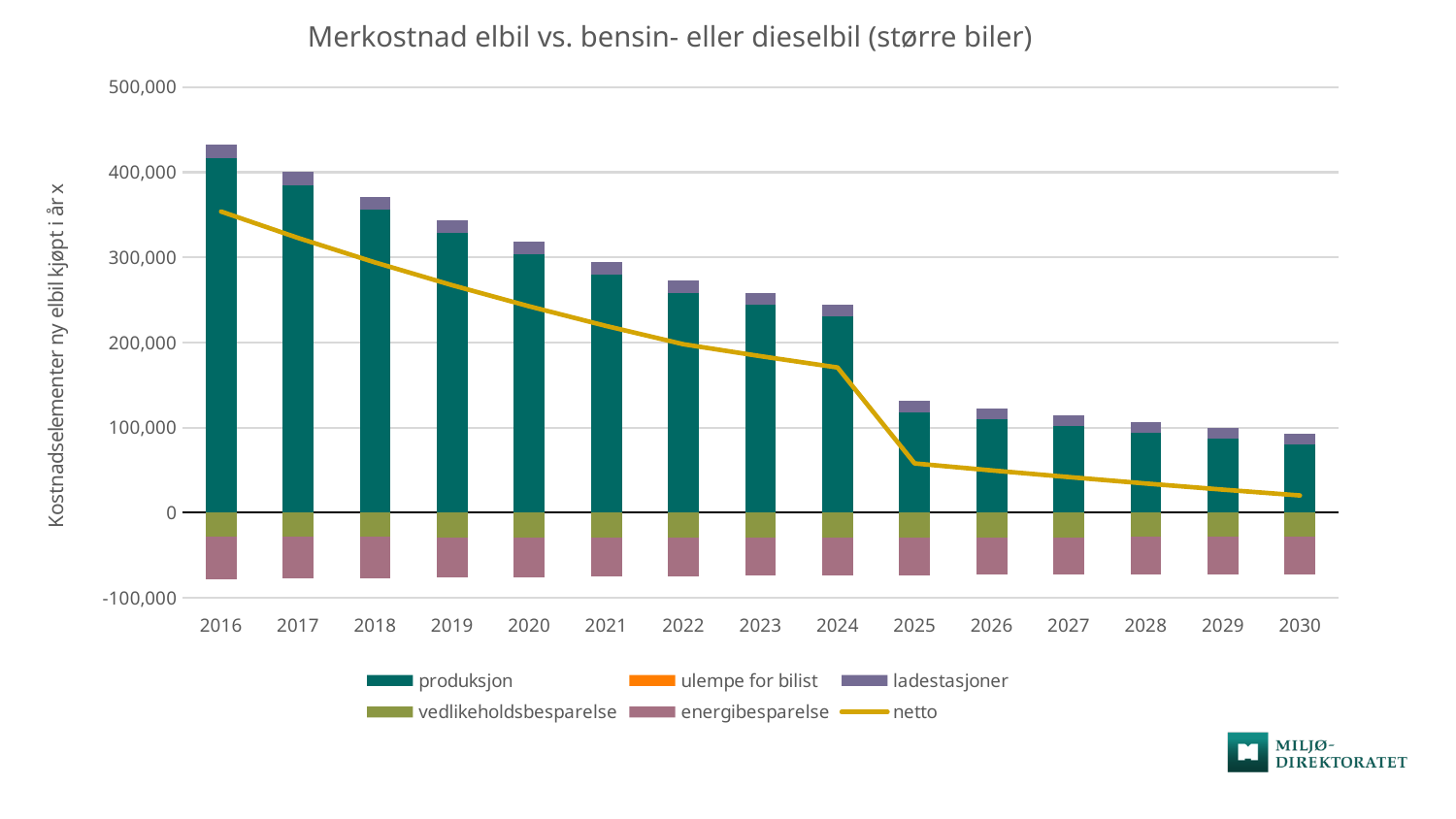
Is the netto value for 2016 greater or less than 300,000? greater Which year has the larger netto value, 2020 or 2025? 2020 Is the netto value for 2030 greater or less than 100,000? less Is the produksjon value for 2016 greater or less than 400,000? greater How many years are shown on the x axis? 15 Does the netto line rise or fall from 2016 to 2030? Fall In which year is the produksjon bar lowest? 2030 In which year is the produksjon bar highest? 2016 How many series does the legend list? 6 What kind of chart is shown on the slide? A stacked bar chart with a line What is the title of the chart? Merkostnad elbil vs. bensin- eller dieselbil (større biler) What is the label on the vertical axis? Kostnadselementer ny elbil kjøpt i år x